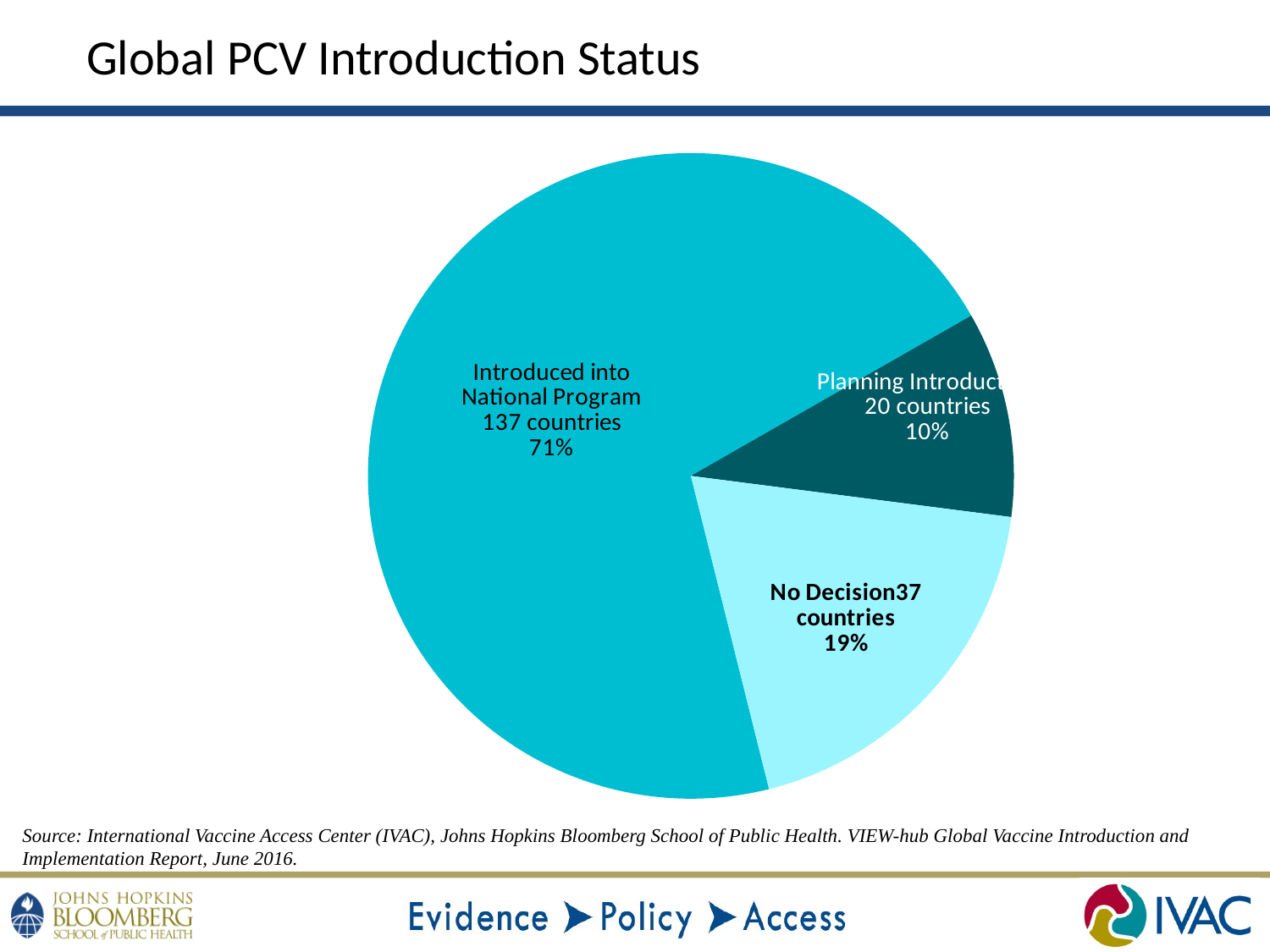
What share of the pie is the 'Planning Introduction' slice? 10% How many slices does the pie chart have? 3 What percentage of the pie does the 'No Decision' slice represent? 19% What is the title of the slide containing the pie chart? Global PCV Introduction Status What share of the pie is the 'Introduced into National Program' slice? 71% How many countries are in the 'Planning Introduction' category? 20 countries How many countries have introduced PCV into their national program? 137 countries Which category has the smallest slice of the pie? Planning Introduction What kind of chart is shown on the slide? Pie chart How many more countries are in 'Introduced into National Program' than in 'No Decision'? 100 countries How many countries are in the 'No Decision' category? 37 countries Which category has the largest slice of the pie? Introduced into National Program